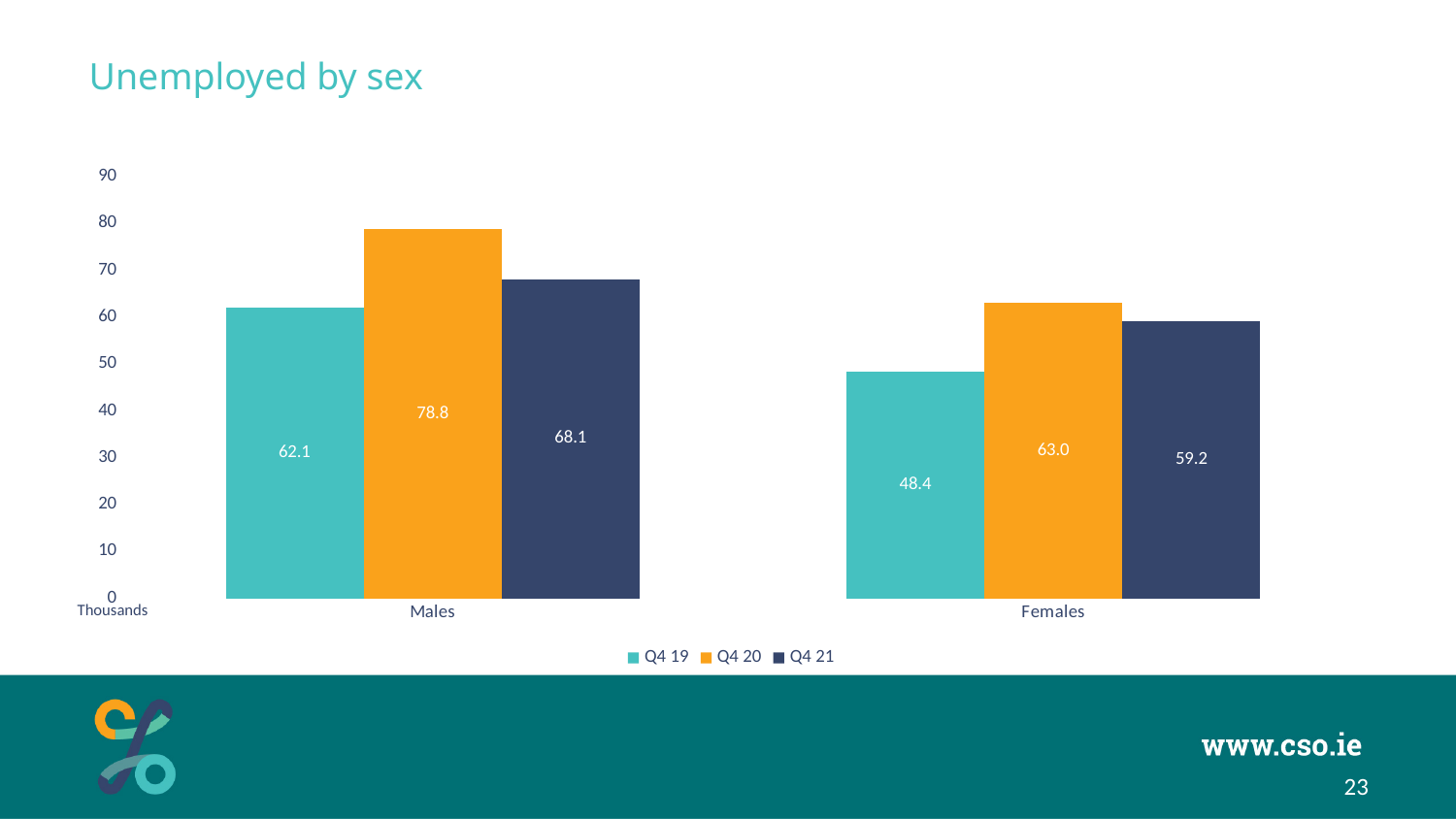
Which series has the lowest value for Females? Q4 19 How many series does the legend list? 3 How many categories are shown on the x axis? 2 What is the difference between the Q4 20 and Q4 21 values for Males? 10.7 Which series has the highest value for Males? Q4 20 What kind of chart is shown on the slide? bar chart What is the value for Females in Q4 21? 59.2 What is the value for Females in Q4 19? 48.4 Which is larger, the Q4 21 value for Males or the Q4 21 value for Females? Males Is the Q4 20 value for Females greater or less than 70? less What is the difference between the Q4 19 values for Males and Females? 13.7 What is the value for Males in Q4 20? 78.8